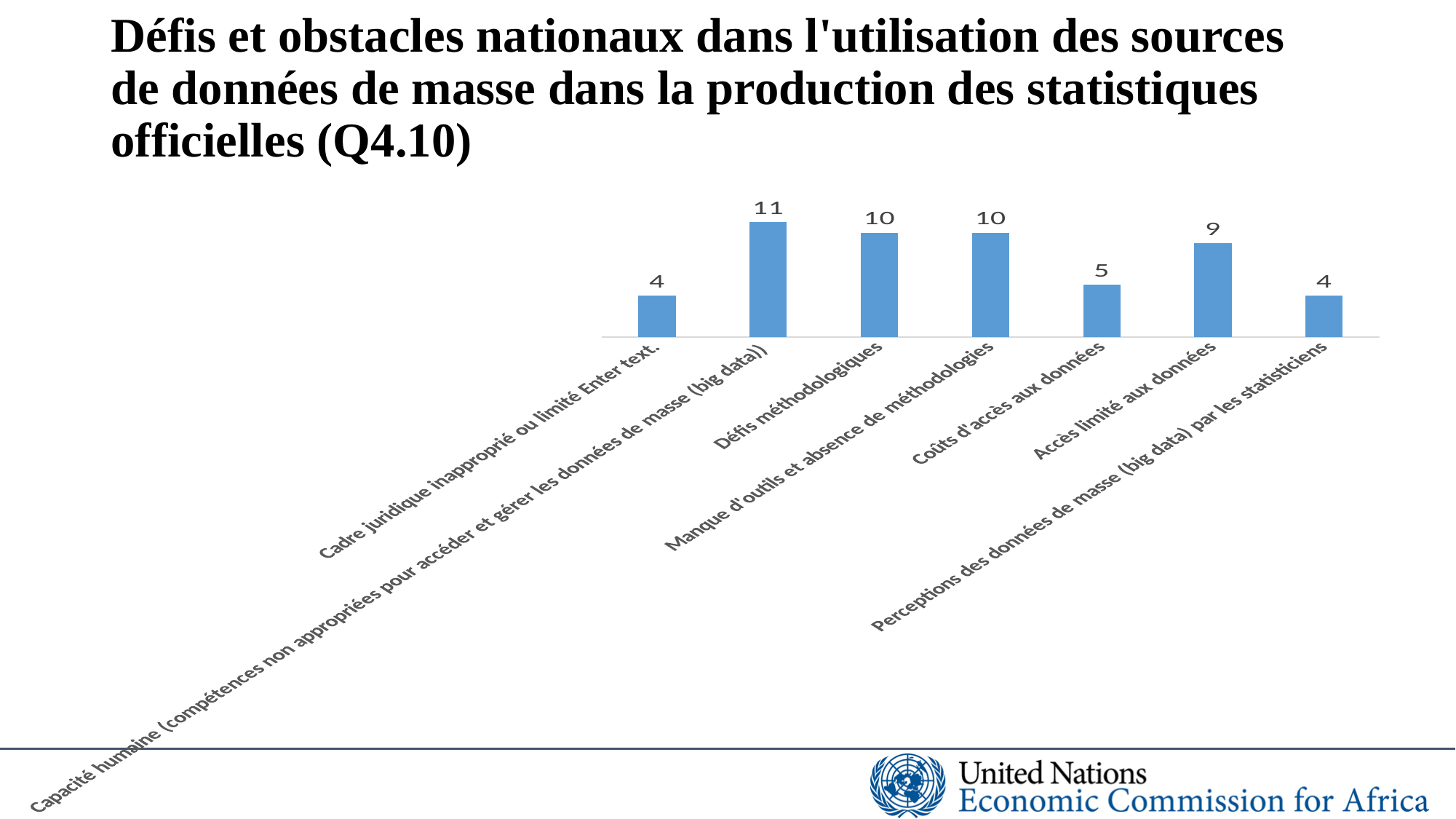
What value is shown for "Accès limité aux données"? 9 What is the difference between the highest value and the value for "Défis méthodologiques"? 1 What value is shown for "Perceptions des données de masse (big data) par les statisticiens"? 4 What value is shown for "Cadre juridique inapproprié ou limité"? 4 What kind of chart is shown on the slide? Bar chart What value is shown for "Coûts d'accès aux données"? 5 Which category has the highest value? Capacité humaine (compétences non appropriées pour accéder et gérer les données de masse (big data)) What colour are the bars in the chart? Blue What value is shown for "Défis méthodologiques"? 10 Which is larger, the value for "Manque d'outils et absence de méthodologies" or the value for "Coûts d'accès aux données"? Manque d'outils et absence de méthodologies What is the difference between the values for "Accès limité aux données" and "Coûts d'accès aux données"? 4 How many categories are shown in the chart? 7